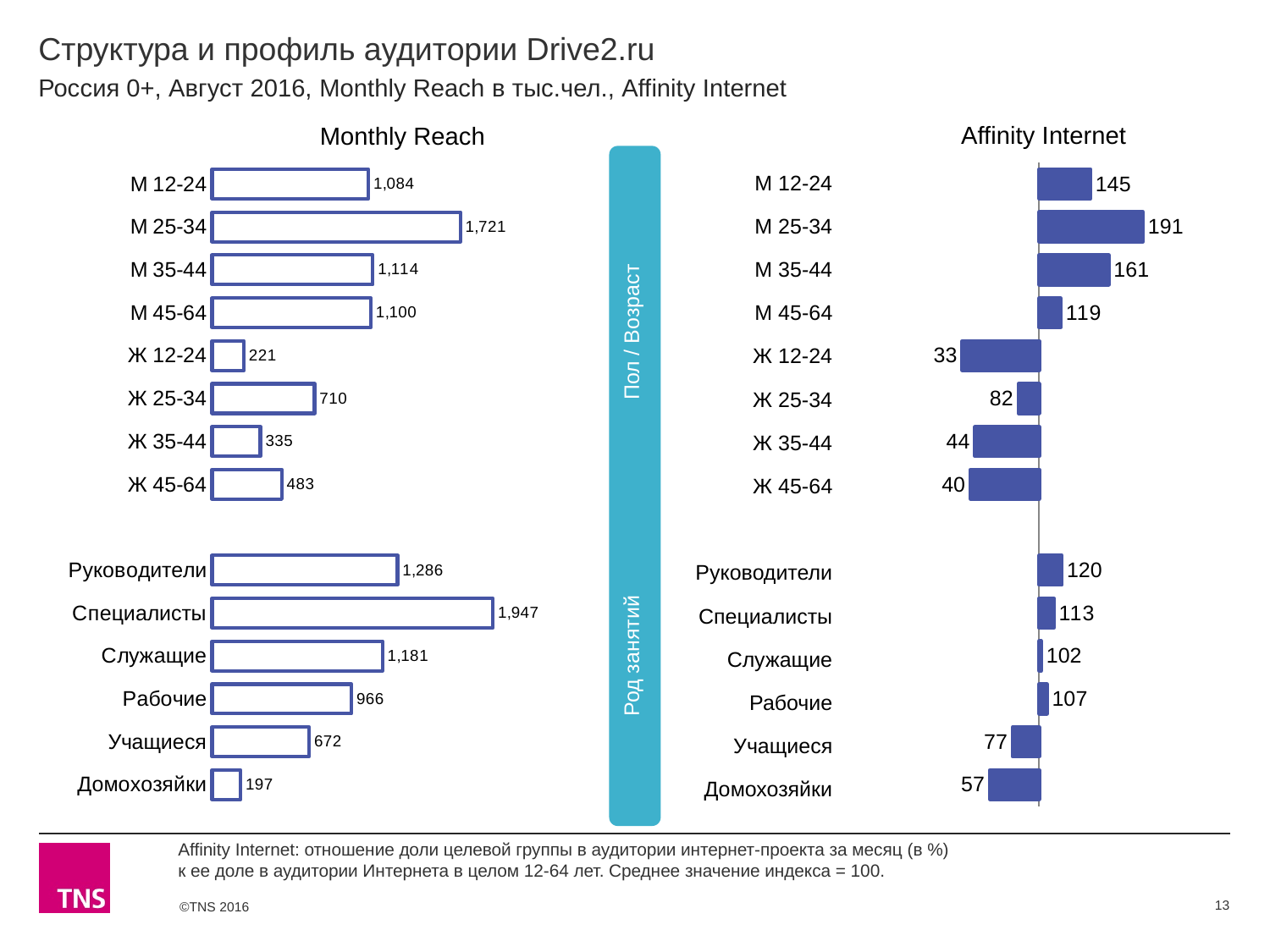
What kind of chart is the Affinity Internet chart? Bar chart In the Monthly Reach chart, which is larger: Ж 45-64 or Ж 35-44? Ж 45-64 In the Monthly Reach chart, what is the value for М 25-34? 1,721 In the Monthly Reach chart, what is the value for Домохозяйки? 197 In the Affinity Internet chart, which is larger: М 35-44 or М 45-64? М 35-44 In the Affinity Internet chart, what is the value for Ж 12-24? 33 In the Affinity Internet chart, which category has the lowest value? Ж 12-24 In the Monthly Reach chart, which category has the highest value? Специалисты How many categories are plotted in the Monthly Reach chart? 14 In the Affinity Internet chart, what is the difference between М 25-34 and Ж 25-34? 109 In the Affinity Internet chart, what is the value for Рабочие? 107 In the Monthly Reach chart, what is the difference between Руководители and Учащиеся? 614